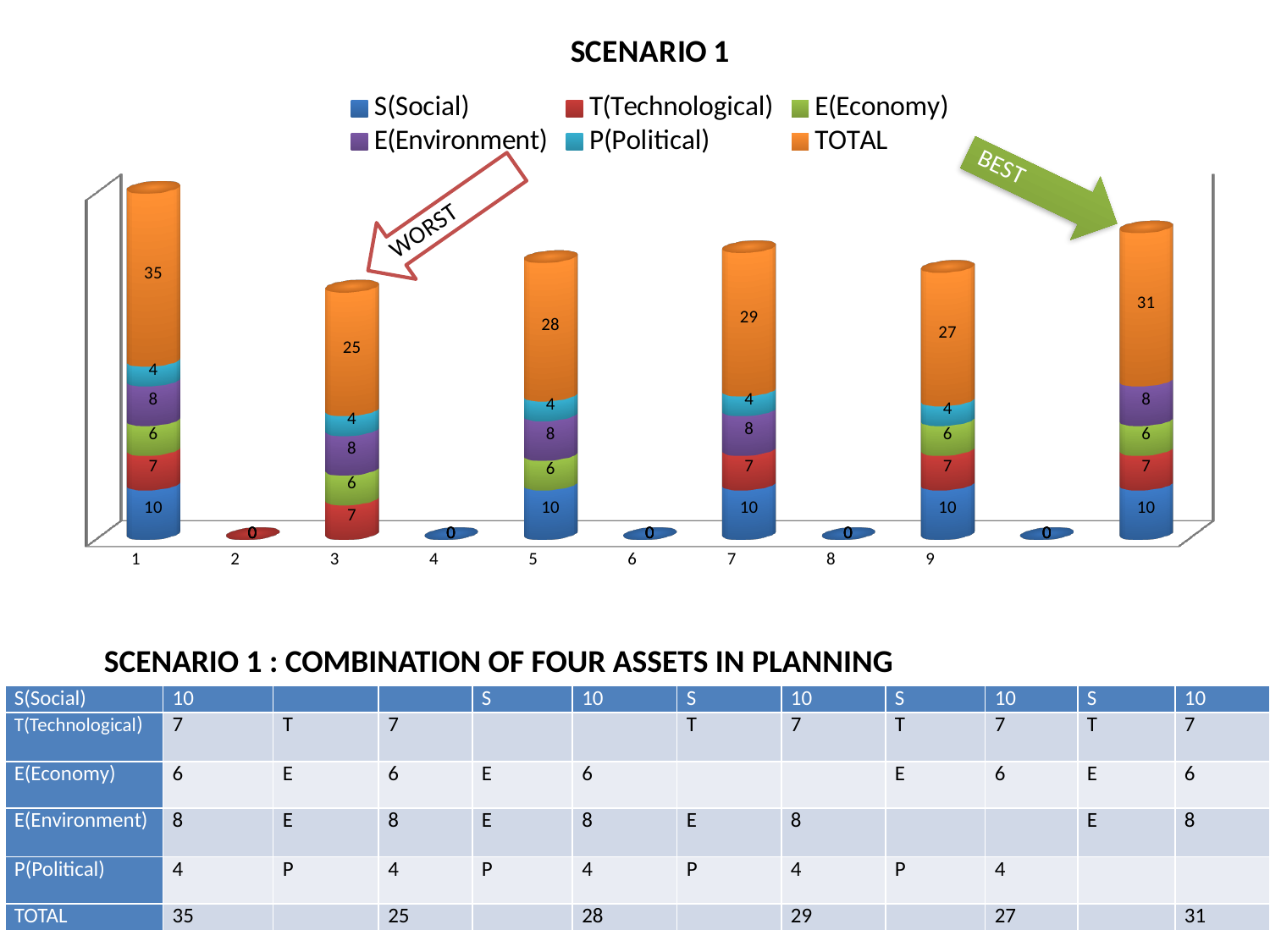
Which category has the lowest non-zero TOTAL value? 3 What is the E(Environment) value for category 5? 8 What is the TOTAL value for category 3? 25 What is the title of the chart? SCENARIO 1 What is the difference between the TOTAL value for category 1 and the TOTAL value for category 3? 10 What kind of chart is shown on the slide? Stacked bar chart How many series does the legend of the SCENARIO 1 chart list? 6 Which category has the highest TOTAL value? 1 What is the TOTAL value for category 9? 27 What is the S(Social) value for category 7? 10 Which category has the larger TOTAL value, 5 or 7? 7 What is the TOTAL value for category 1? 35